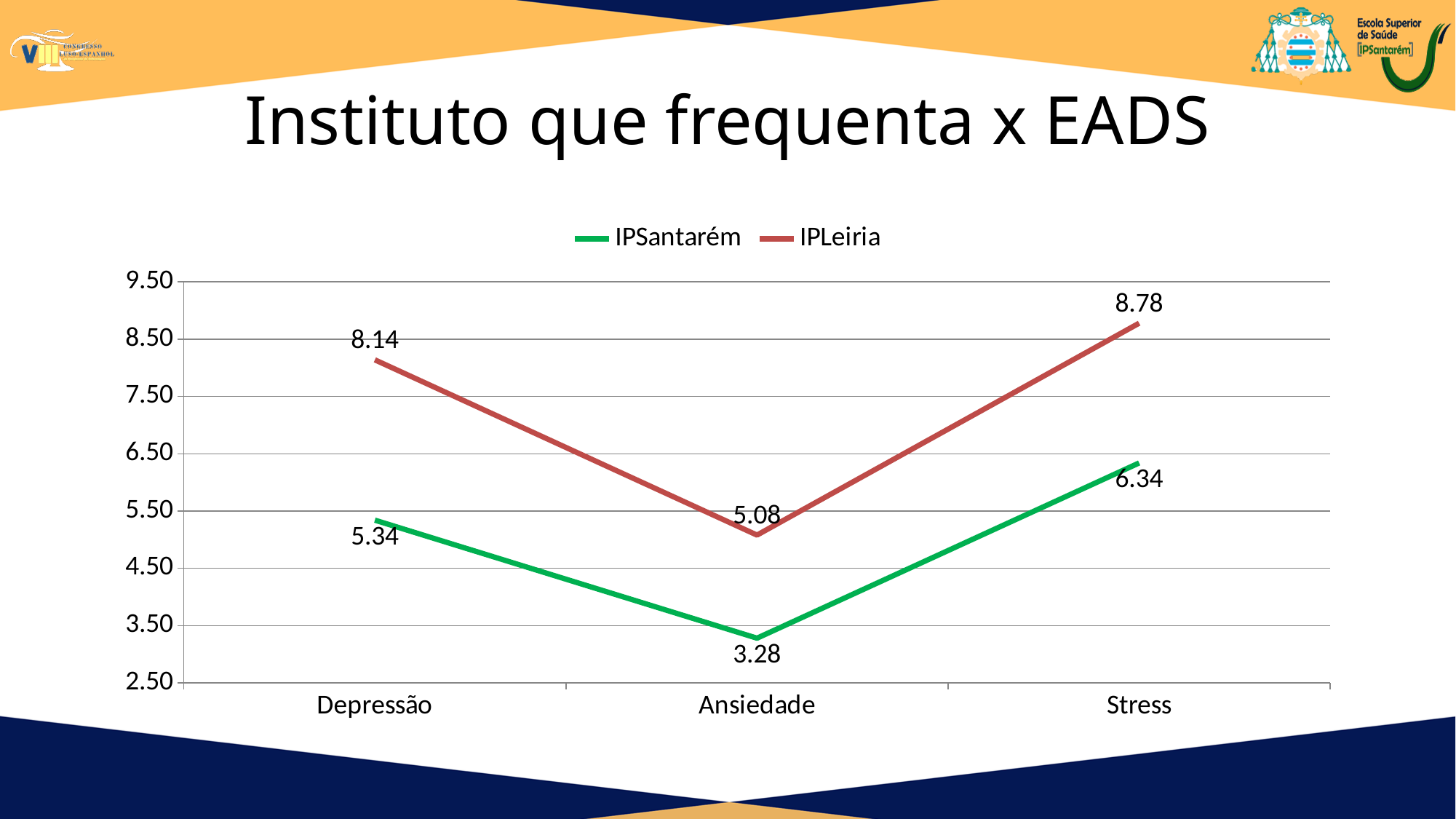
What is the IPLeiria value for Depressão? 8.14 What is the IPLeiria value for Stress? 8.78 How many series does the legend list? 2 What is the title of the slide? Instituto que frequenta x EADS What is the IPSantarém value for Depressão? 5.34 Which category has the highest IPLeiria value? Stress What is the IPSantarém value for Ansiedade? 3.28 How many categories are shown on the x axis? 3 What kind of chart is shown on the slide? Line chart Which category has the lowest IPSantarém value? Ansiedade Which is larger for Ansiedade: IPSantarém or IPLeiria? IPLeiria What is the difference between the IPLeiria and IPSantarém values for Stress? 2.44